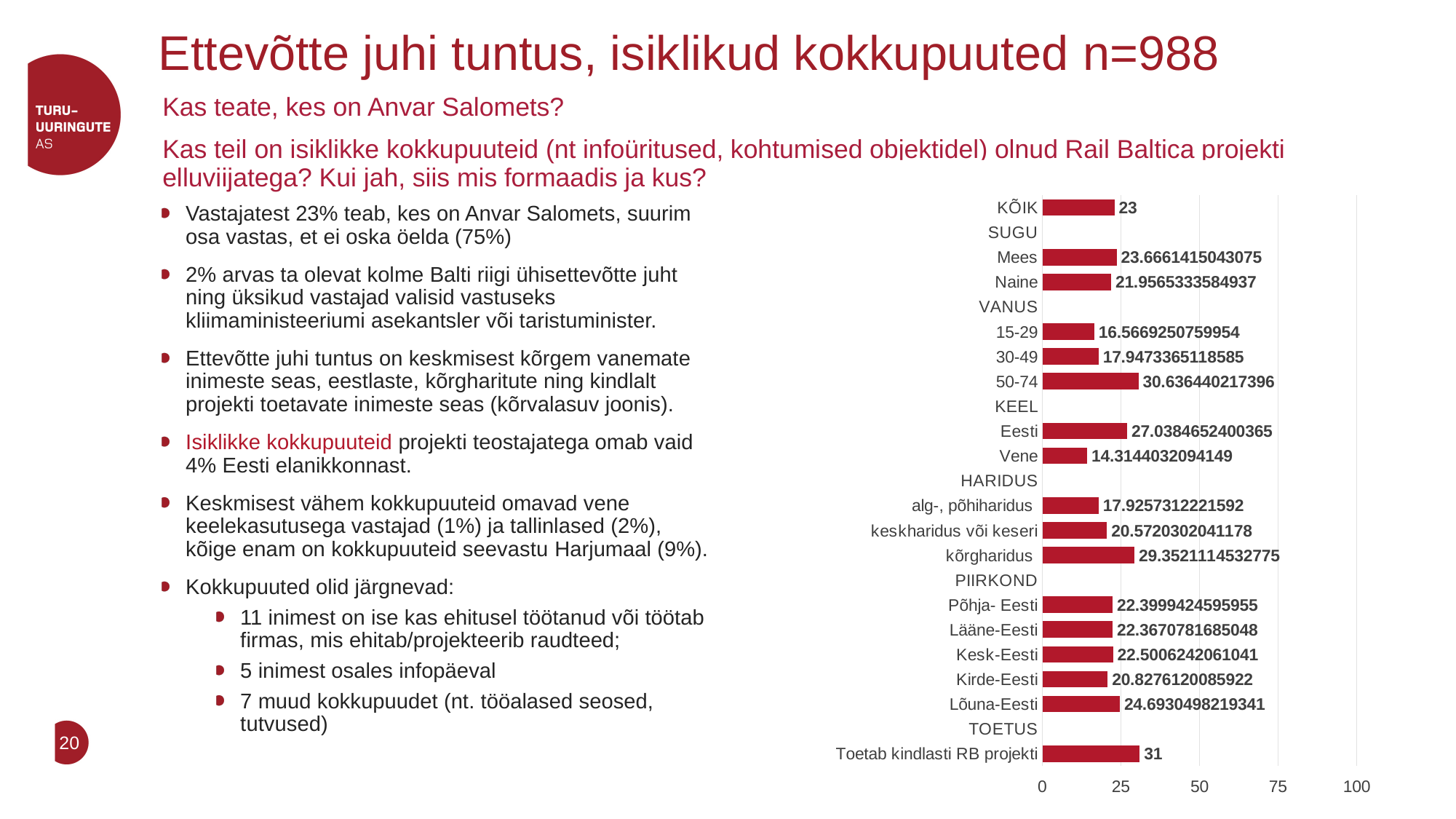
What is the value for Vene in the chart? 14.3144032094149 What is the value for Toetab kindlasti RB projekti in the chart? 31 What is the value for 50-74 in the chart? 30.636440217396 Which category has the lowest value in the chart? Vene Is the value for kõrgharidus greater or less than 25? greater Which has a larger value, Eesti or Vene? Eesti How many bars are plotted in the chart? 17 What is the value for KÕIK in the chart? 23 Which has a larger value, 50-74 or 15-29? 50-74 What is the difference between the values for Toetab kindlasti RB projekti and KÕIK? 8 Which category has the highest value in the chart? Toetab kindlasti RB projekti What kind of chart is shown on the slide? bar chart